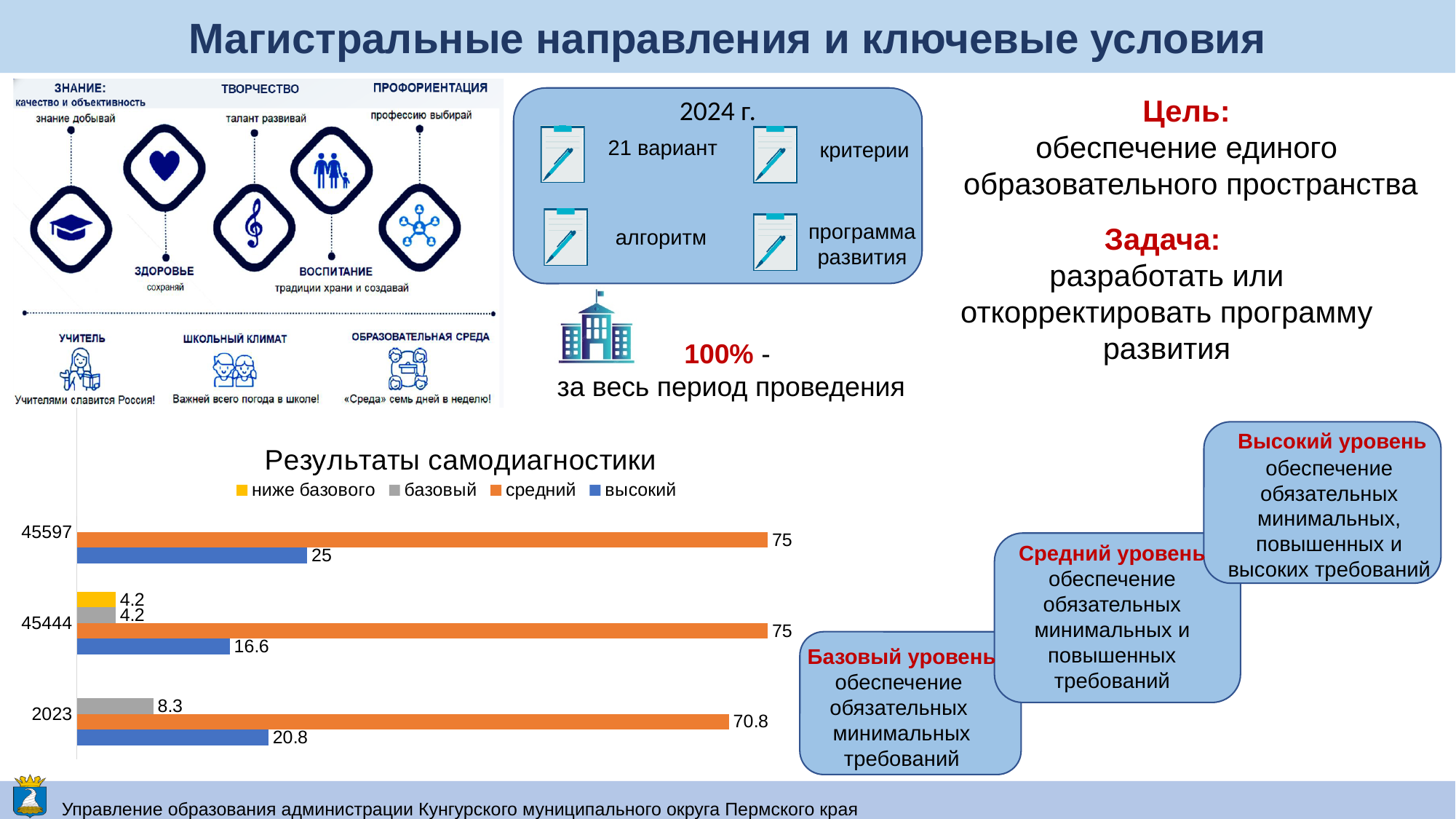
In the "Результаты самодиагностики" chart, what is the value of "высокий" for the category 45444? 16.6 In the "Результаты самодиагностики" chart, which category has the highest value for "высокий"? 45597 In the "Результаты самодиагностики" chart, what is the difference between the "высокий" values for 45597 and 45444? 8.4 How many categories are shown on the vertical axis of the "Результаты самодиагностики" chart? 3 In the "Результаты самодиагностики" chart, what is the value of "ниже базового" for the category 45444? 4.2 How many series does the legend of the "Результаты самодиагностики" chart list? 4 In the "Результаты самодиагностики" chart, which category has the lowest value for "средний"? 2023 What kind of chart is "Результаты самодиагностики"? bar chart In the "Результаты самодиагностики" chart, what is the value of "базовый" for the category 2023? 8.3 In the "Результаты самодиагностики" chart, what is the value of "средний" for the category 2023? 70.8 In the "Результаты самодиагностики" chart, which is larger for the category 2023: "высокий" or "базовый"? высокий What is the title of the chart on the slide? Результаты самодиагностики